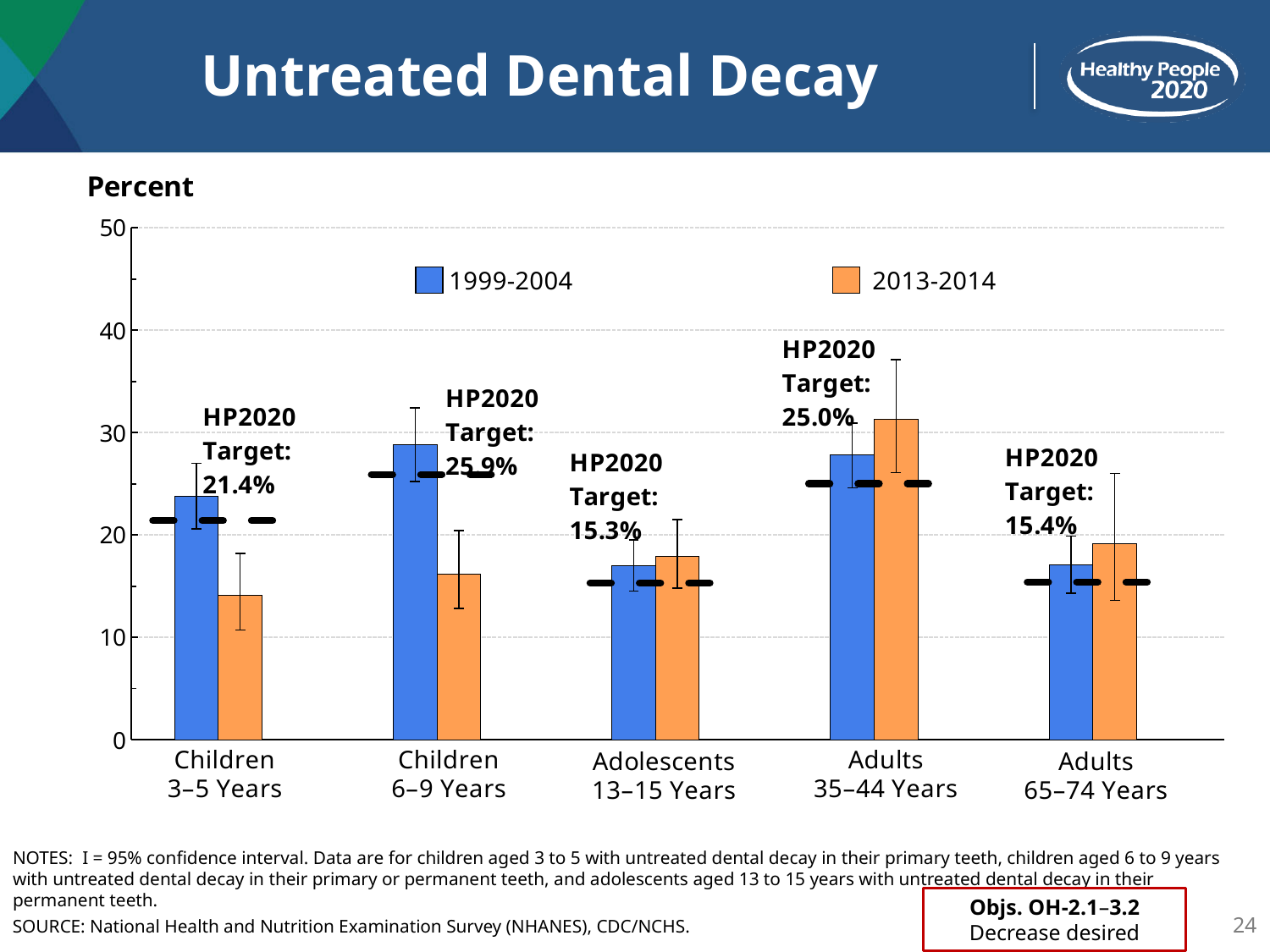
Is the 2013-2014 value for Children 6–9 Years greater or less than 20? less What is the title of the chart? Untreated Dental Decay Is the 1999-2004 value for Children 3–5 Years greater or less than 20? greater What is the HP2020 Target printed for Children 3–5 Years? 21.4% How many series does the legend list? 2 What kind of chart is shown on the slide? Bar chart How many age-group categories are shown on the x axis? 5 Is the 2013-2014 value for Adults 35–44 Years greater or less than 30? greater For Children 6–9 Years, which period has the larger value, 1999-2004 or 2013-2014? 1999-2004 What is the HP2020 Target printed for Adults 35–44 Years? 25.0% What is the HP2020 Target printed for Adolescents 13–15 Years? 15.3% Among the 2013-2014 bars, which age group has the highest value? Adults 35–44 Years